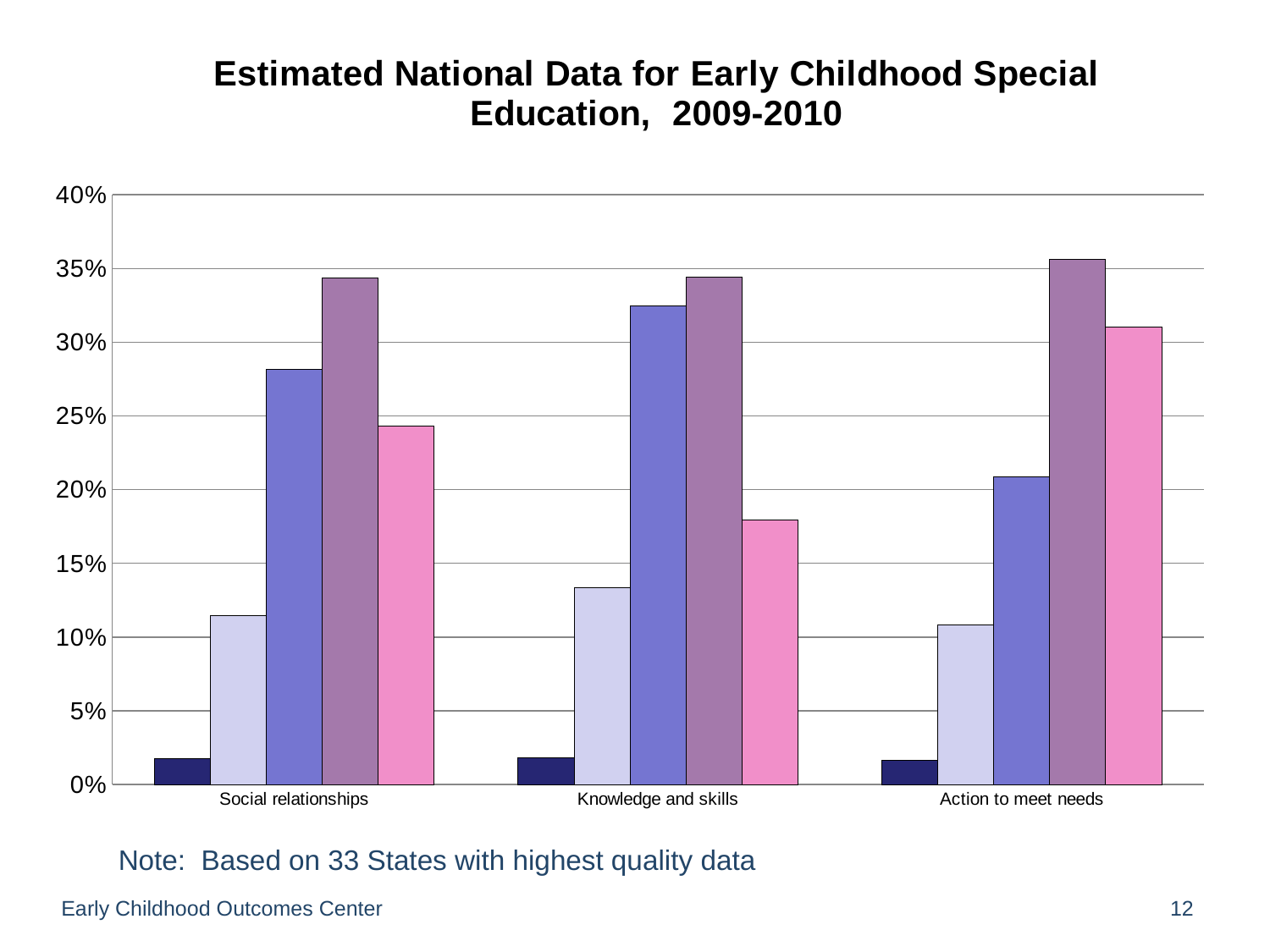
Within the Social relationships category, which bar is the shortest? the dark navy (first) bar Is the value of the mauve (fourth) bar for Action to meet needs greater or less than 30%? greater What is the highest value shown on the chart's vertical axis? 40% How many bars are plotted for each category in the chart? 5 Is the value of the blue (third) bar for Social relationships greater or less than 25%? greater Is the value of the pink (rightmost) bar for Knowledge and skills greater or less than 20%? less Which category has the larger blue (third) bar, Knowledge and skills or Action to meet needs? Knowledge and skills What is the title of the chart? Estimated National Data for Early Childhood Special Education, 2009-2010 Which category has the larger pink (rightmost) bar, Social relationships or Knowledge and skills? Social relationships What kind of chart is shown on the slide? bar chart How many categories are shown on the x axis of the chart? 3